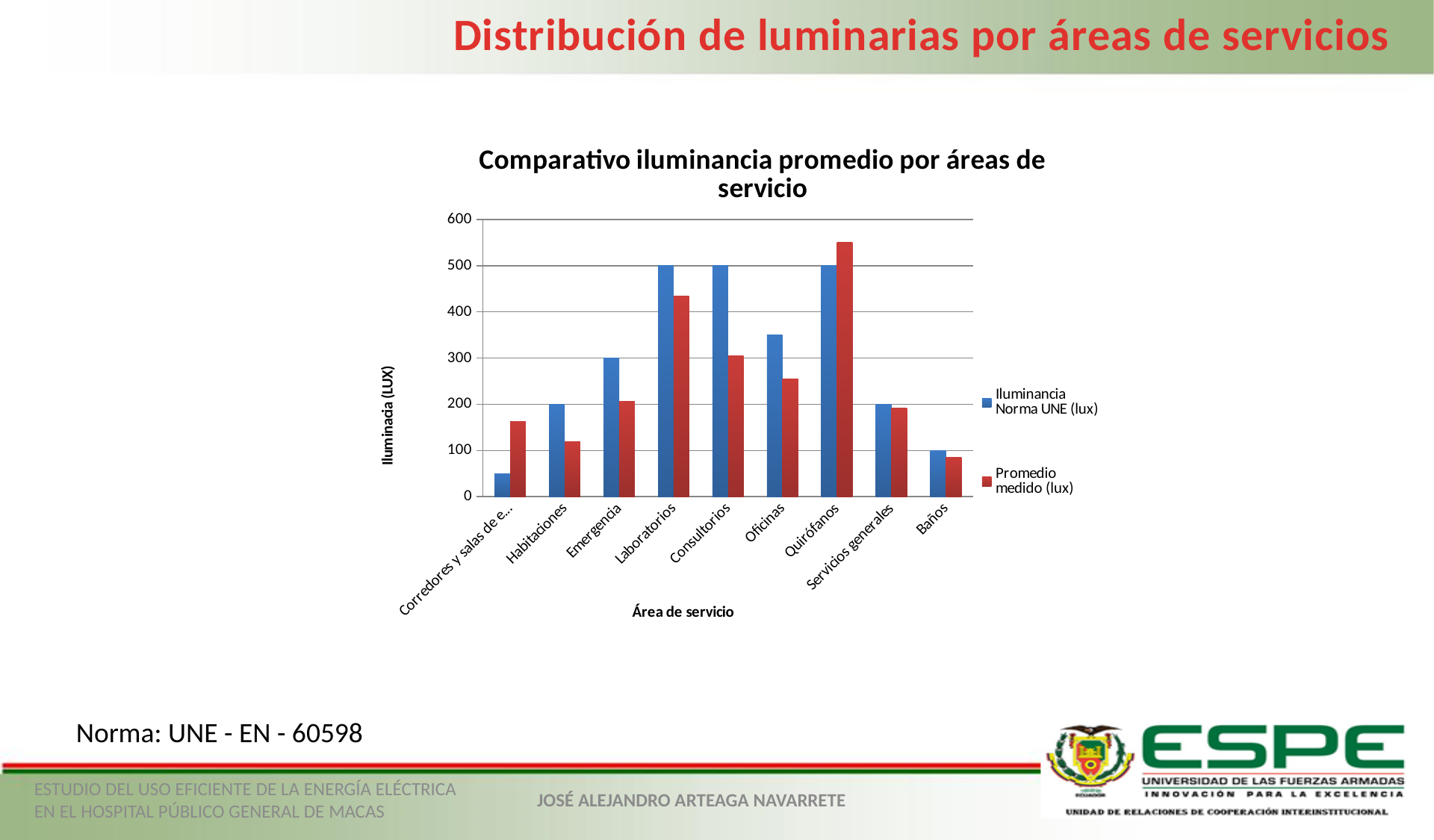
Which service area has the highest Promedio medido (lux) value? Quirófanos How many series does the legend list? 2 Is the Promedio medido (lux) value for Baños greater or less than 100? less What is the Iluminancia Norma UNE (lux) value for Emergencia? 300 Is the Promedio medido (lux) value for Quirófanos greater or less than 500? greater What is the title of the chart? Comparativo iluminancia promedio por áreas de servicio Which service area has the lowest Iluminancia Norma UNE (lux) value? Corredores y salas de e... What is the Iluminancia Norma UNE (lux) value for Laboratorios? 500 How many service areas are shown on the x axis? 9 For Oficinas, which is larger: Iluminancia Norma UNE (lux) or Promedio medido (lux)? Iluminancia Norma UNE (lux) What is the Iluminancia Norma UNE (lux) value for Baños? 100 What type of chart is shown on the slide? Bar chart